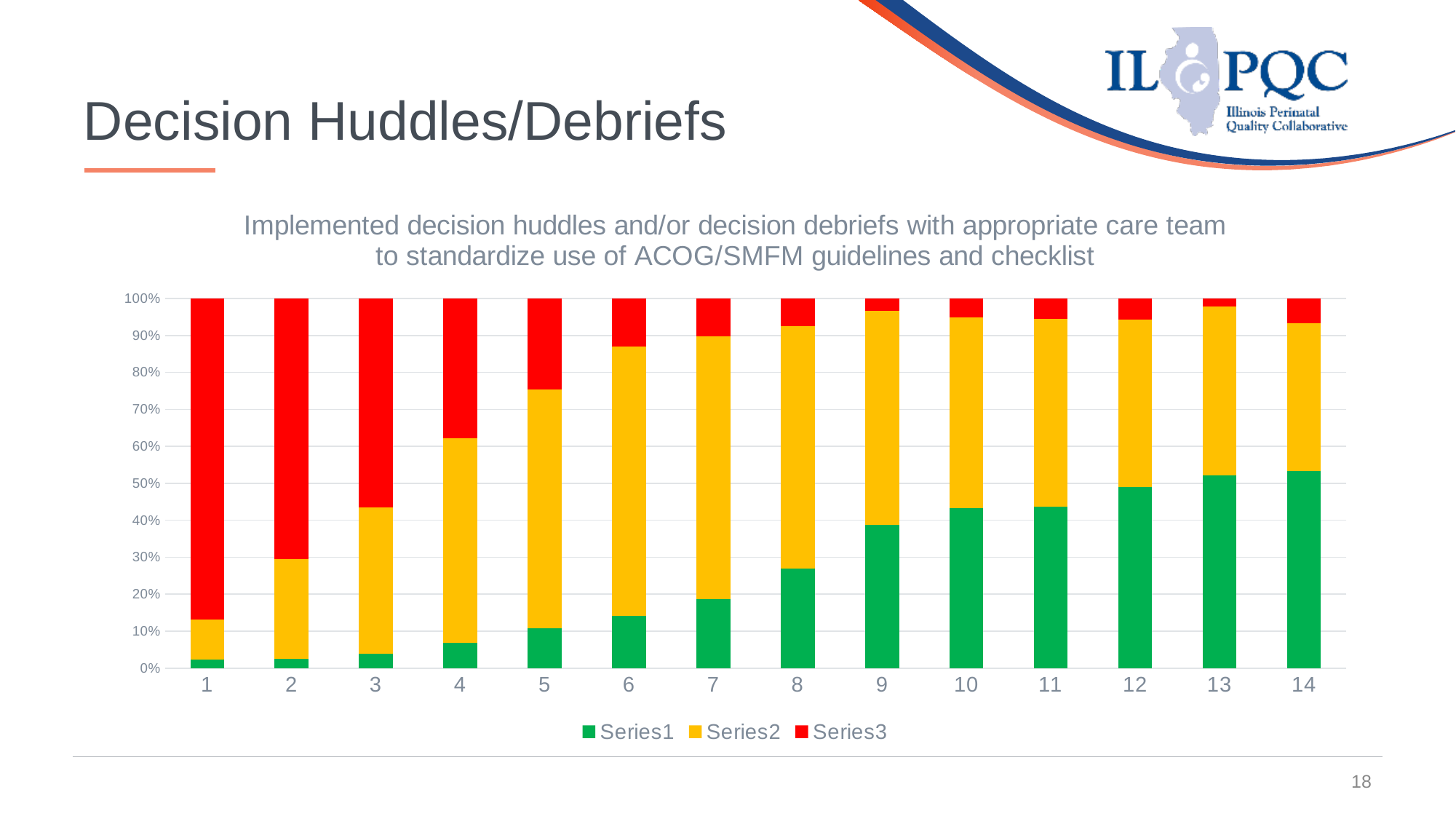
Is the Series3 value for category 1 greater or less than 80%? greater How many categories are shown along the x axis of the chart? 14 How many series does the chart's legend list? 3 Is the Series1 value for category 14 greater or less than 40%? greater Does the Series3 (red) segment rise or fall as you move from category 1 to category 14? Fall Which category has the largest Series3 (red) segment? 1 What kind of chart is shown on the slide? Stacked bar chart Which has the larger Series1 segment, category 4 or category 8? Category 8 Is the Series1 value for category 1 greater or less than 10%? less Does the Series1 (green) segment rise or fall as you move from category 1 to category 14? Rise Which has the larger Series3 segment, category 3 or category 5? Category 3 What is the total of the stacked bar for category 7? 100%